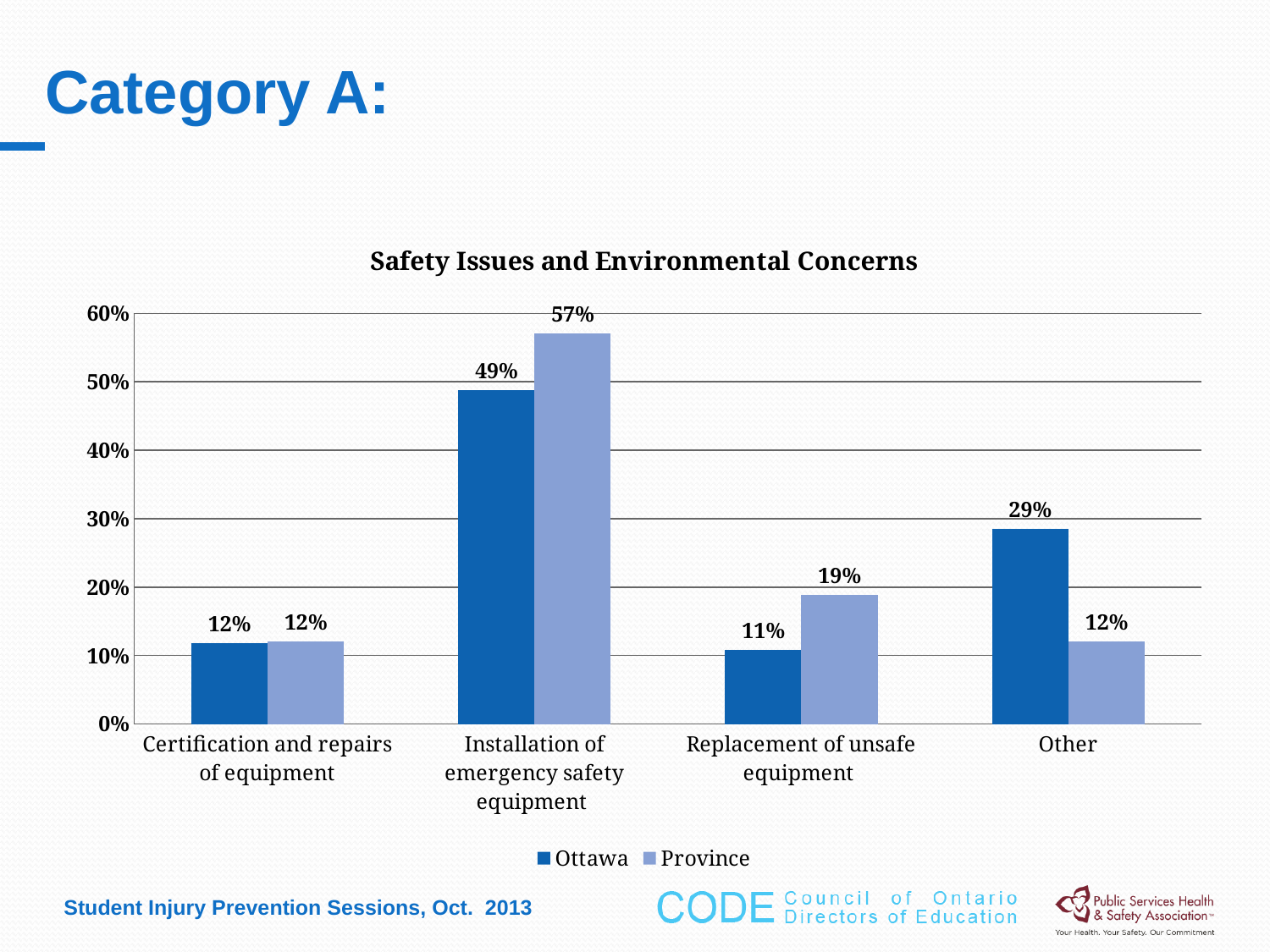
What is the Ottawa value for Other? 29% What type of chart is shown on the slide? Bar chart How many series does the legend list? 2 Which category has the lowest Ottawa value? Replacement of unsafe equipment How many categories are shown on the x axis? 4 Which category has the highest Province value? Installation of emergency safety equipment What is the difference between the Province and Ottawa values for Installation of emergency safety equipment? 8% What is the Ottawa value for Installation of emergency safety equipment? 49% What is the Province value for Replacement of unsafe equipment? 19% For Replacement of unsafe equipment, which is larger, the Ottawa value or the Province value? Province Is the Ottawa value for Installation of emergency safety equipment greater or less than 40%? greater What is the difference between the Ottawa and Province values for Other? 17%